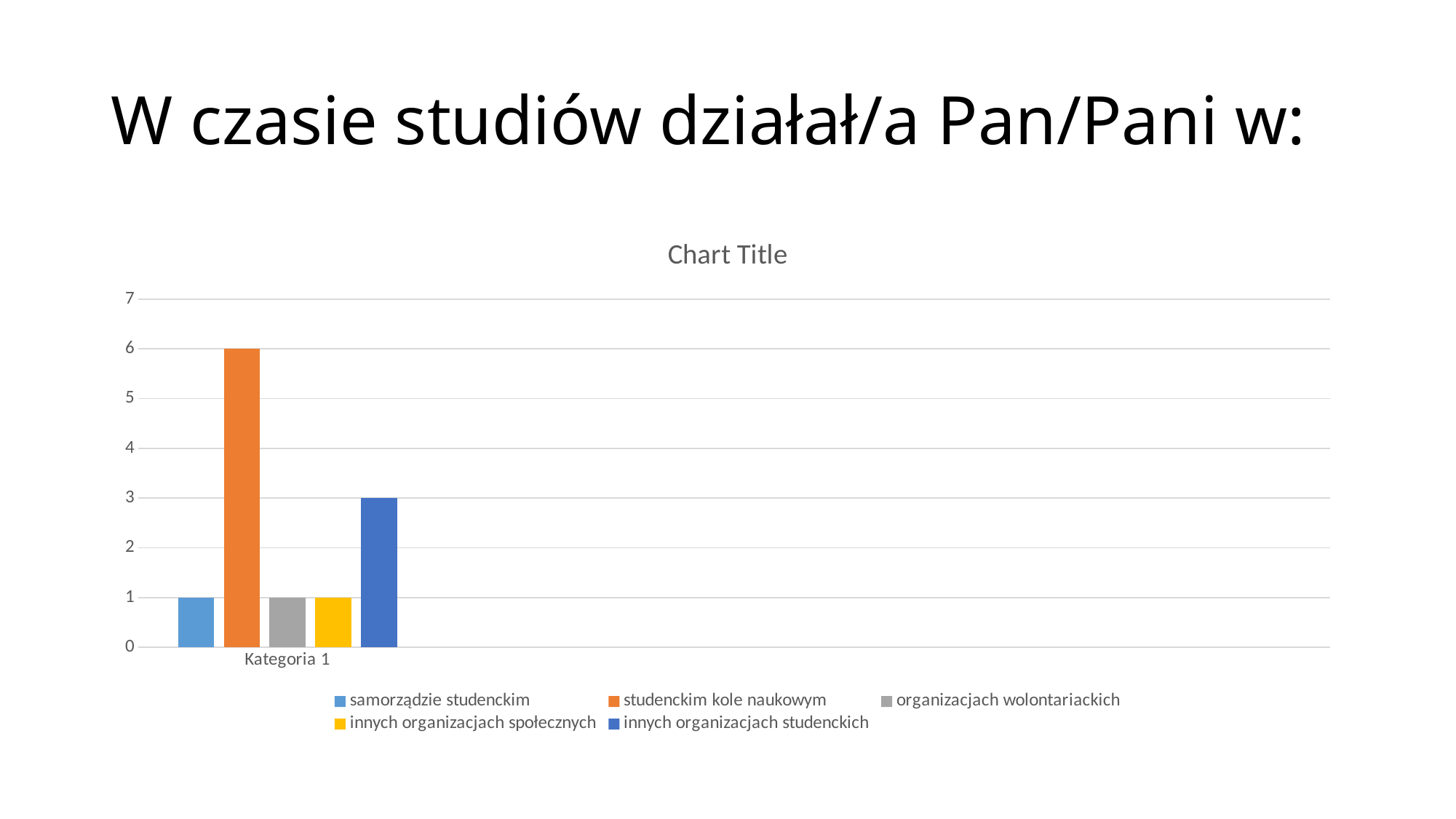
How many categories are shown on the x axis? 1 What kind of chart is shown on the slide? bar chart How many series does the legend list? 5 What is the value for 'samorządzie studenckim'? 1 What is the value for 'studenckim kole naukowym'? 6 What is the difference between the values for 'studenckim kole naukowym' and 'innych organizacjach studenckich'? 3 Which is larger, the value for 'innych organizacjach studenckich' or the value for 'organizacjach wolontariackich'? innych organizacjach studenckich What colour is the bar for 'innych organizacjach społecznych'? yellow What is the value for 'innych organizacjach studenckich'? 3 What is the title shown above the chart? Chart Title Which series has the highest value? studenckim kole naukowym Is the value for 'studenckim kole naukowym' greater or less than 5? greater